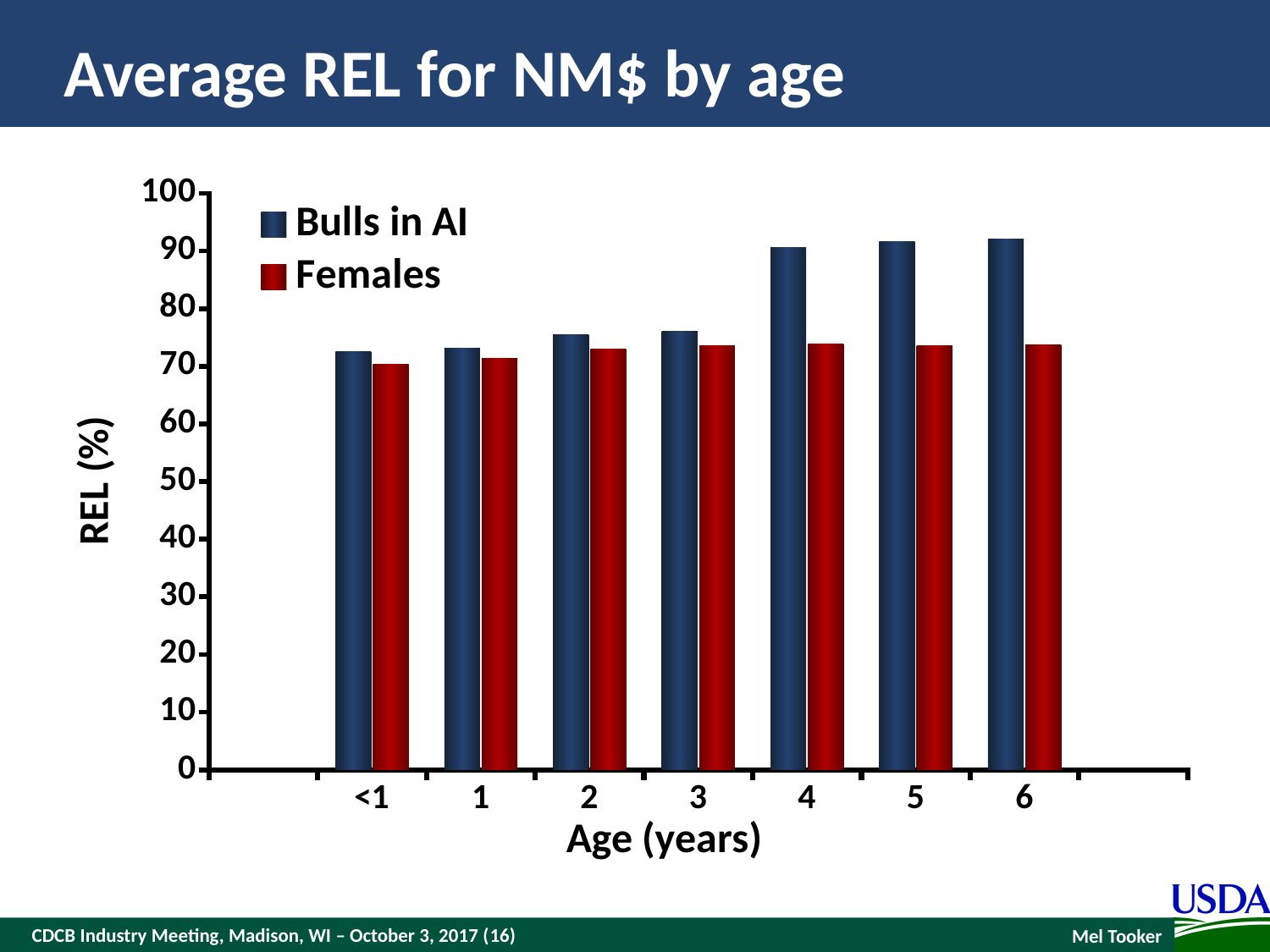
How many series does the legend list? 2 Which is larger for Bulls in AI: the value at age 3 or the value at age 4? age 4 What are the two series named in the legend? Bulls in AI and Females Do the values for Bulls in AI generally rise or fall as age increases? rise Is the value for Females at age 4 greater or less than 80? less How many age categories are shown on the x axis? 7 Is the value for Bulls in AI at age 6 greater or less than 90? greater What is the label of the y axis? REL (%) Is the value for Females at age 6 greater or less than 70? greater Which is larger at age 4: the value for Bulls in AI or the value for Females? Bulls in AI What kind of chart is shown on the slide? bar chart